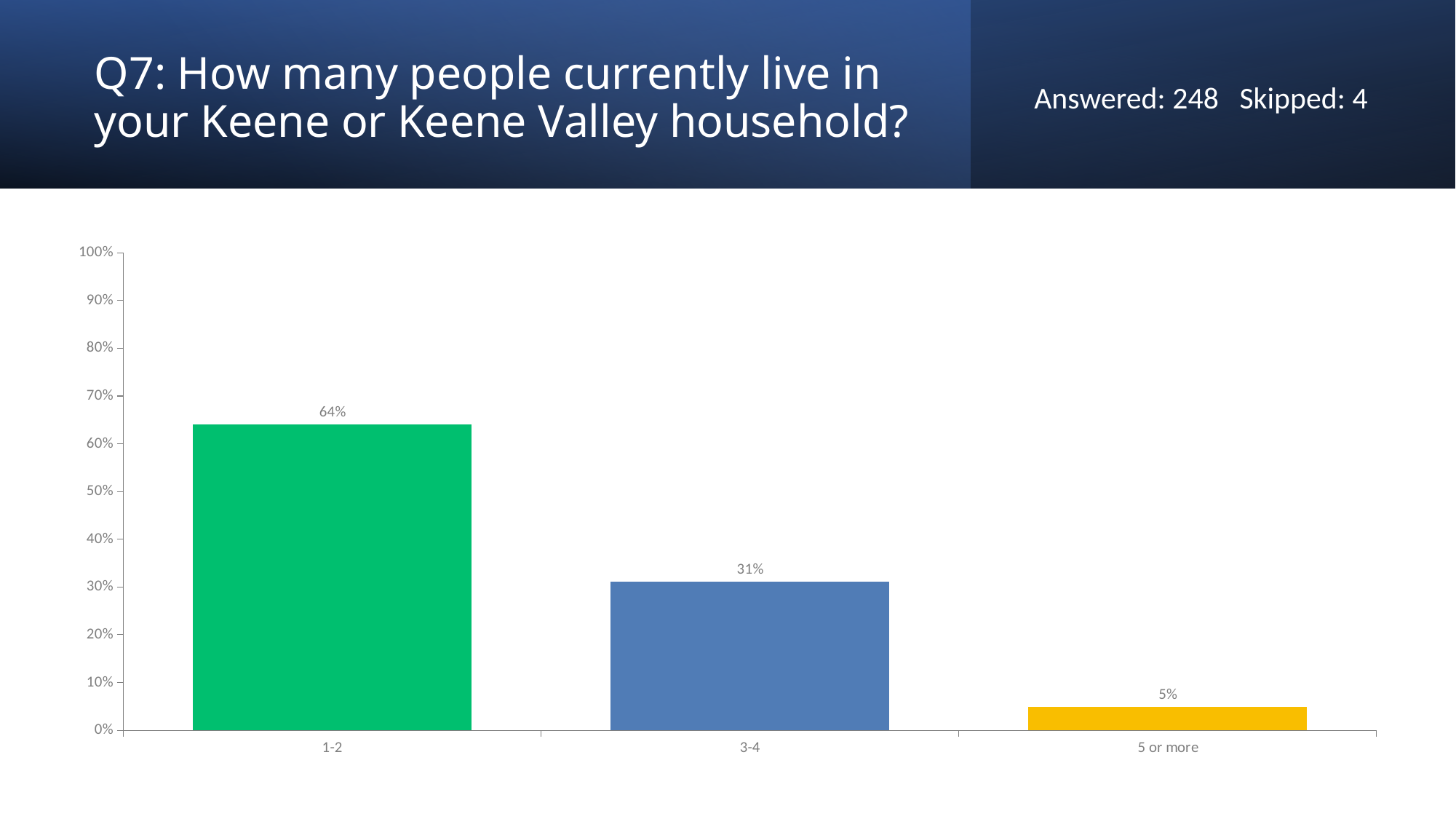
Which is larger, the value for 3-4 or the value for 5 or more? 3-4 What is the difference in percentage points between the 3-4 and '5 or more' categories? 26 What percentage of respondents live in a household of 1-2 people? 64% How many household size categories are shown on the x axis? 3 Do the values rise or fall moving from left to right along the x axis? Fall What percentage is shown for the '5 or more' category? 5% What kind of chart is shown on the slide? Bar chart What is the difference in percentage points between the 1-2 and 3-4 categories? 33 Is the value for 1-2 greater or less than 50%? greater Which household size category has the highest percentage? 1-2 What is the value shown for the 3-4 category? 31% Which household size category has the lowest percentage? 5 or more